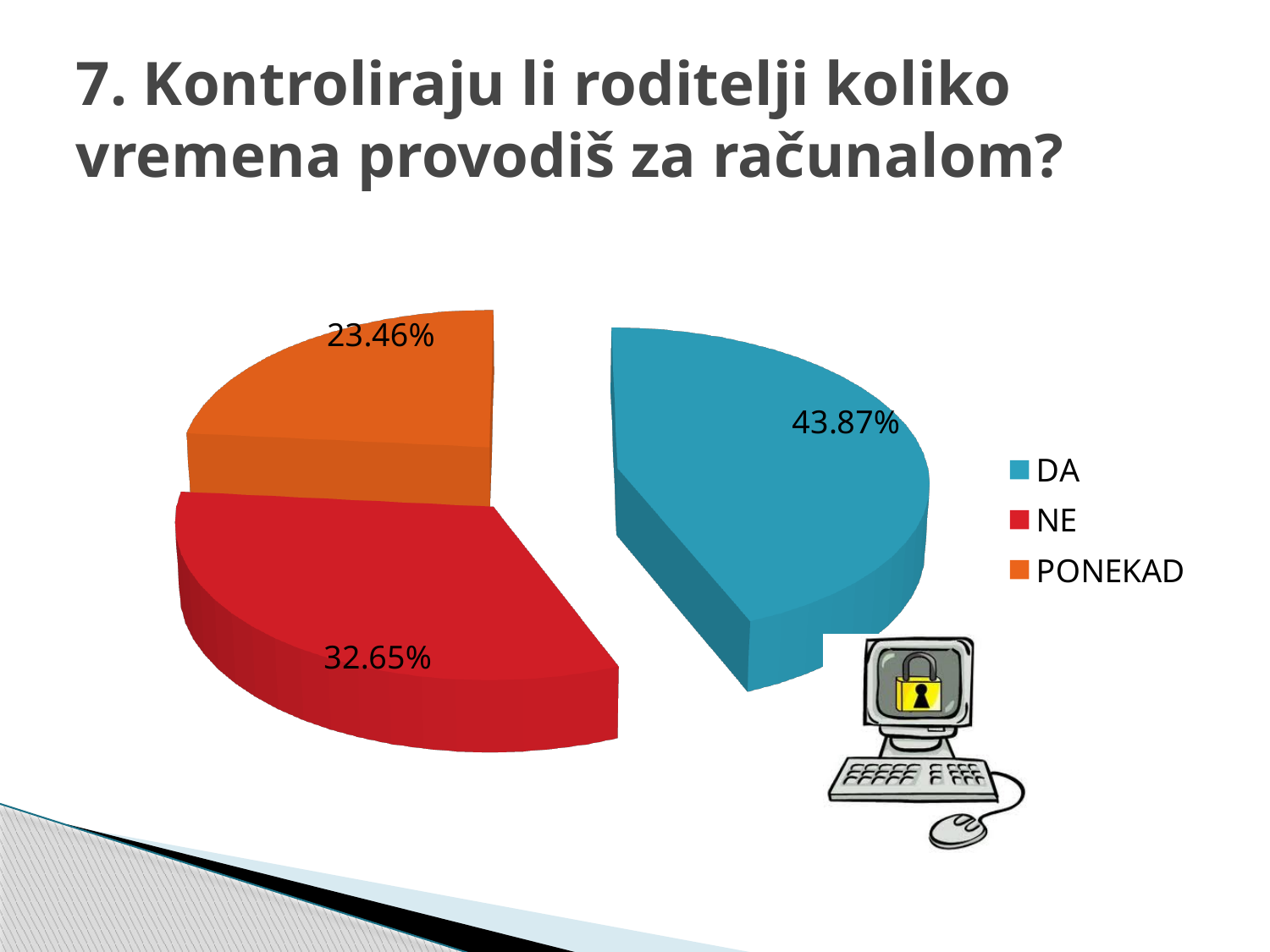
What percentage of the pie is the DA slice? 43.87% What is the difference in percentage points between the NE and PONEKAD slices? 9.19 What kind of chart is shown on the slide? Pie chart What is the difference in percentage points between the DA and NE slices? 11.22 What colour is the NE slice in the pie chart? Red Which category has the largest share of the pie? DA Which category has the smallest share of the pie? PONEKAD How many entries does the legend list? 3 Which slice is larger, NE or PONEKAD? NE What percentage of the pie is the NE slice? 32.65% How many slices does the pie chart have? 3 What percentage of the pie is the PONEKAD slice? 23.46%